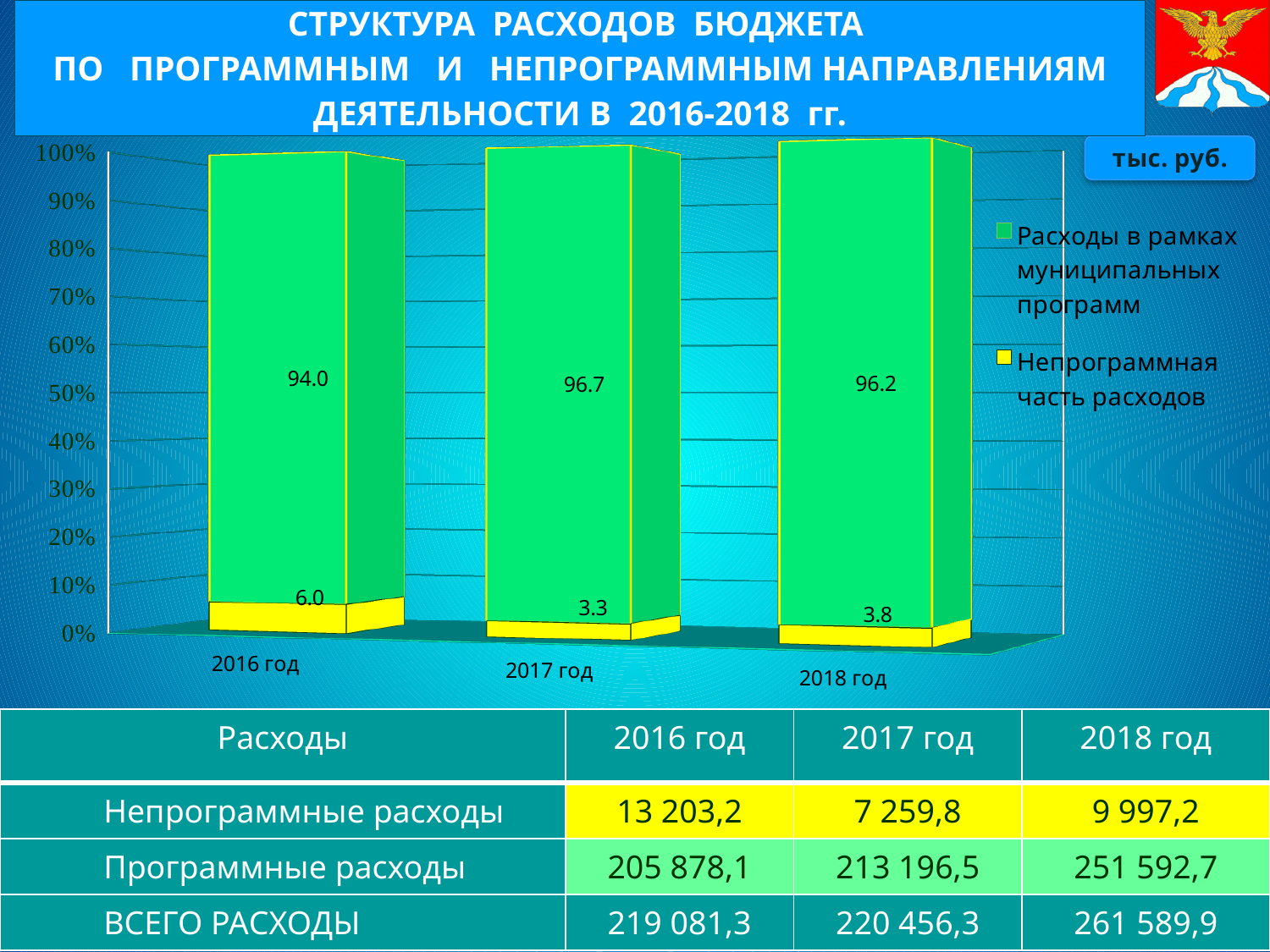
What is the value of 'Непрограммная часть расходов' for 2017 год? 3.3 Which is larger: the 'Непрограммная часть расходов' value for 2016 год or for 2018 год? 2016 год Is the 'Расходы в рамках муниципальных программ' value for 2018 год greater or less than 90%? greater How many years (categories) are shown on the x axis of the chart? 3 What is the value of 'Непрограммная часть расходов' for 2018 год? 3.8 What kind of chart is shown on the slide? Stacked bar chart In which year is the share of 'Расходы в рамках муниципальных программ' the highest? 2017 год Which colour represents 'Непрограммная часть расходов' in the chart? Yellow What is the difference between the 'Расходы в рамках муниципальных программ' values for 2017 год and 2016 год? 2.7 What is the value of 'Расходы в рамках муниципальных программ' for 2016 год? 94.0 How many series does the chart legend list? 2 In which year is the share of 'Непрограммная часть расходов' the lowest? 2017 год